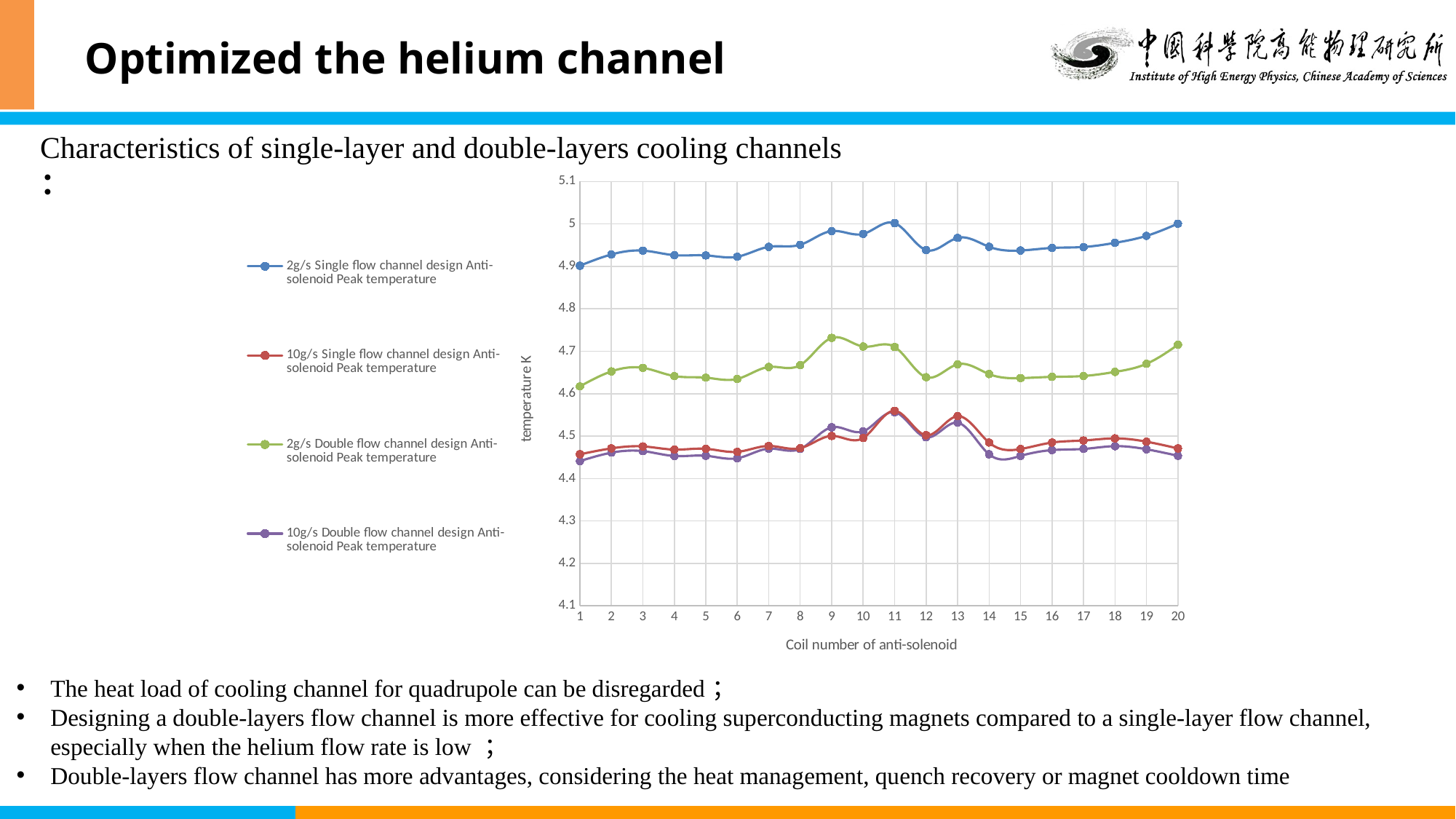
Does the 2g/s Single flow channel design series rise or fall from coil 11 to coil 12? Fall At which coil number does the 2g/s Double flow channel design series reach its highest value? 9 Which series has the highest peak temperature values across all coils? 2g/s Single flow channel design Anti-solenoid Peak temperature At coil 9, which is larger: the 2g/s Double flow channel design value or the 10g/s Single flow channel design value? 2g/s Double flow channel design At which coil number does the 2g/s Single flow channel design series reach its highest value? 11 How many coil numbers are plotted along the x axis? 20 What kind of chart is shown on the slide? Line chart How many series does the chart legend list? 4 What is the title of the x axis? Coil number of anti-solenoid Is the value for the 2g/s Double flow channel design series at coil 9 greater or less than 4.7? greater Is the value for the 10g/s Double flow channel design series at coil 15 greater or less than 4.5? less Is the value for the 2g/s Single flow channel design series at coil 9 greater or less than 4.9? greater